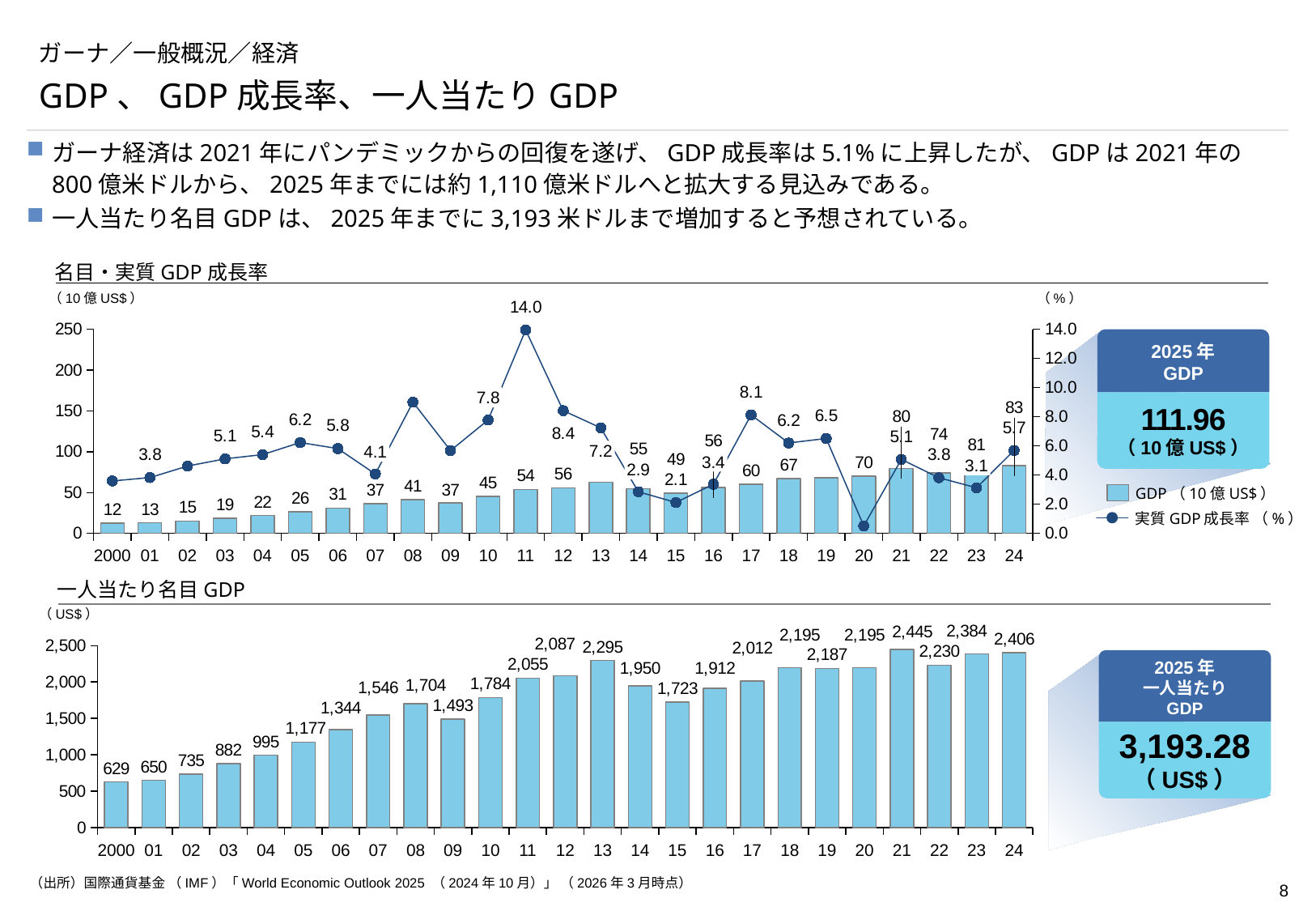
In the top chart (名目・実質GDP成長率), what is the GDP value (10億US$) for 2024? 83 In the top chart (名目・実質GDP成長率), what is the difference between the GDP values for 2021 and 2020? 10 In the bottom chart (一人当たり名目GDP), which year has the highest value? 2021 In the bottom chart (一人当たり名目GDP), how many years are plotted? 25 In the bottom chart (一人当たり名目GDP), which year has the lowest value? 2000 In the top chart (名目・実質GDP成長率), which year has the highest 実質GDP成長率? 2011 What kind of chart is the bottom chart (一人当たり名目GDP)? bar chart In the top chart (名目・実質GDP成長率), is the 実質GDP成長率 for 2020 greater or less than 2.0? less In the top chart (名目・実質GDP成長率), what is the 実質GDP成長率 for 2011? 14.0 In the top chart (名目・実質GDP成長率), how many series does the legend list? 2 In the bottom chart (一人当たり名目GDP), what is the value for 2013? 2,295 In the bottom chart (一人当たり名目GDP), which is larger, the value for 2015 or the value for 2016? 2016